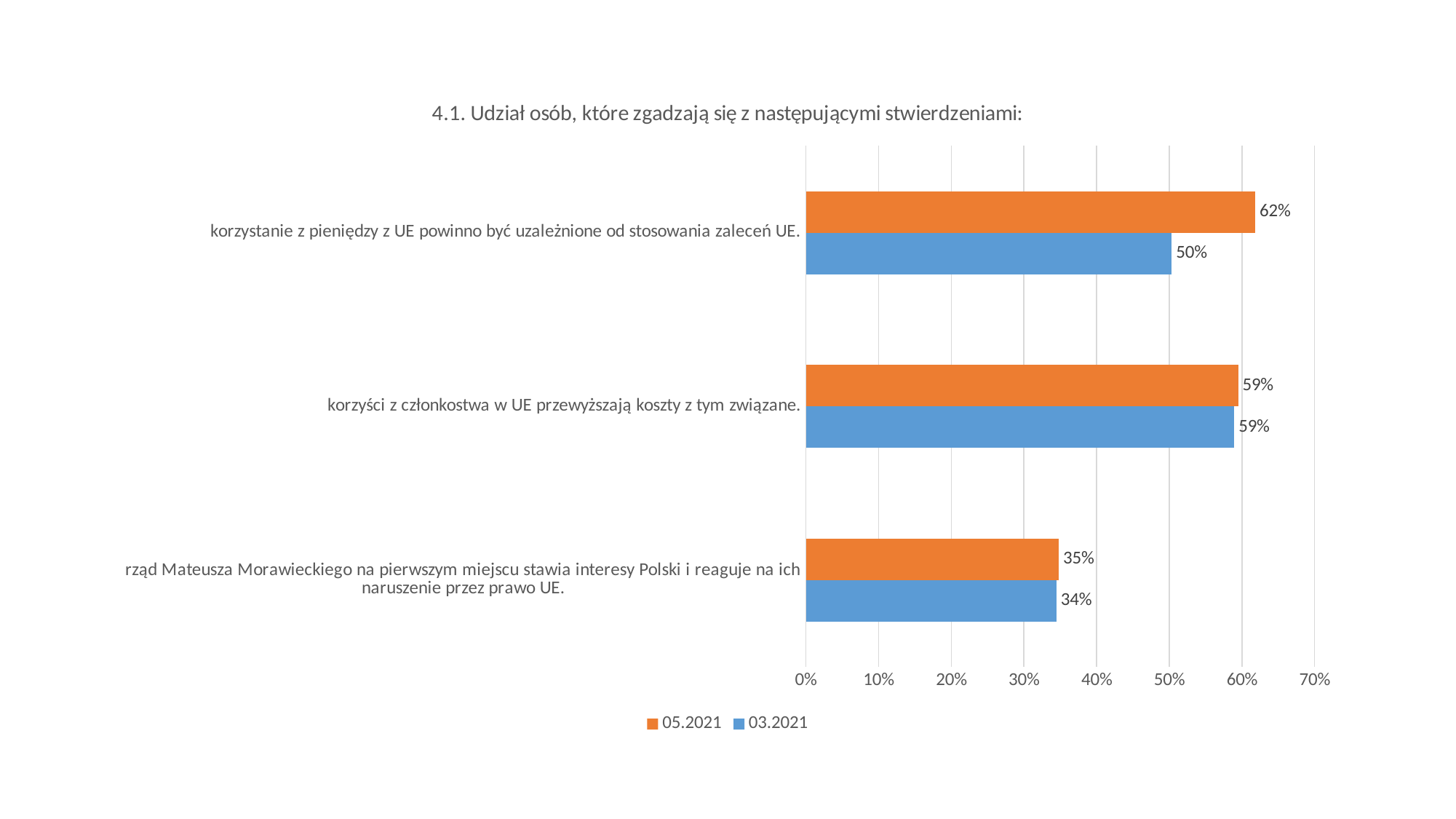
How many statements (categories) are shown in the chart? 3 What is the difference between the 05.2021 and 03.2021 values for the statement "korzystanie z pieniędzy z UE powinno być uzależnione od stosowania zaleceń UE."? 12% Which colour represents the 03.2021 series? Blue How many series does the legend list? 2 What is the 05.2021 value for the statement "korzystanie z pieniędzy z UE powinno być uzależnione od stosowania zaleceń UE."? 62% What kind of chart is shown on the slide? Bar chart Which statement has the highest 05.2021 value? korzystanie z pieniędzy z UE powinno być uzależnione od stosowania zaleceń UE. For the statement "rząd Mateusza Morawieckiego na pierwszym miejscu stawia interesy Polski i reaguje na ich naruszenie przez prawo UE.", which series has the larger value, 05.2021 or 03.2021? 05.2021 Which statement has the lowest 03.2021 value? rząd Mateusza Morawieckiego na pierwszym miejscu stawia interesy Polski i reaguje na ich naruszenie przez prawo UE. What is the 03.2021 value for the statement "korzystanie z pieniędzy z UE powinno być uzależnione od stosowania zaleceń UE."? 50% What is the 03.2021 value for the statement "rząd Mateusza Morawieckiego na pierwszym miejscu stawia interesy Polski i reaguje na ich naruszenie przez prawo UE."? 34% What is the 05.2021 value for the statement "korzyści z członkostwa w UE przewyższają koszty z tym związane."? 59%